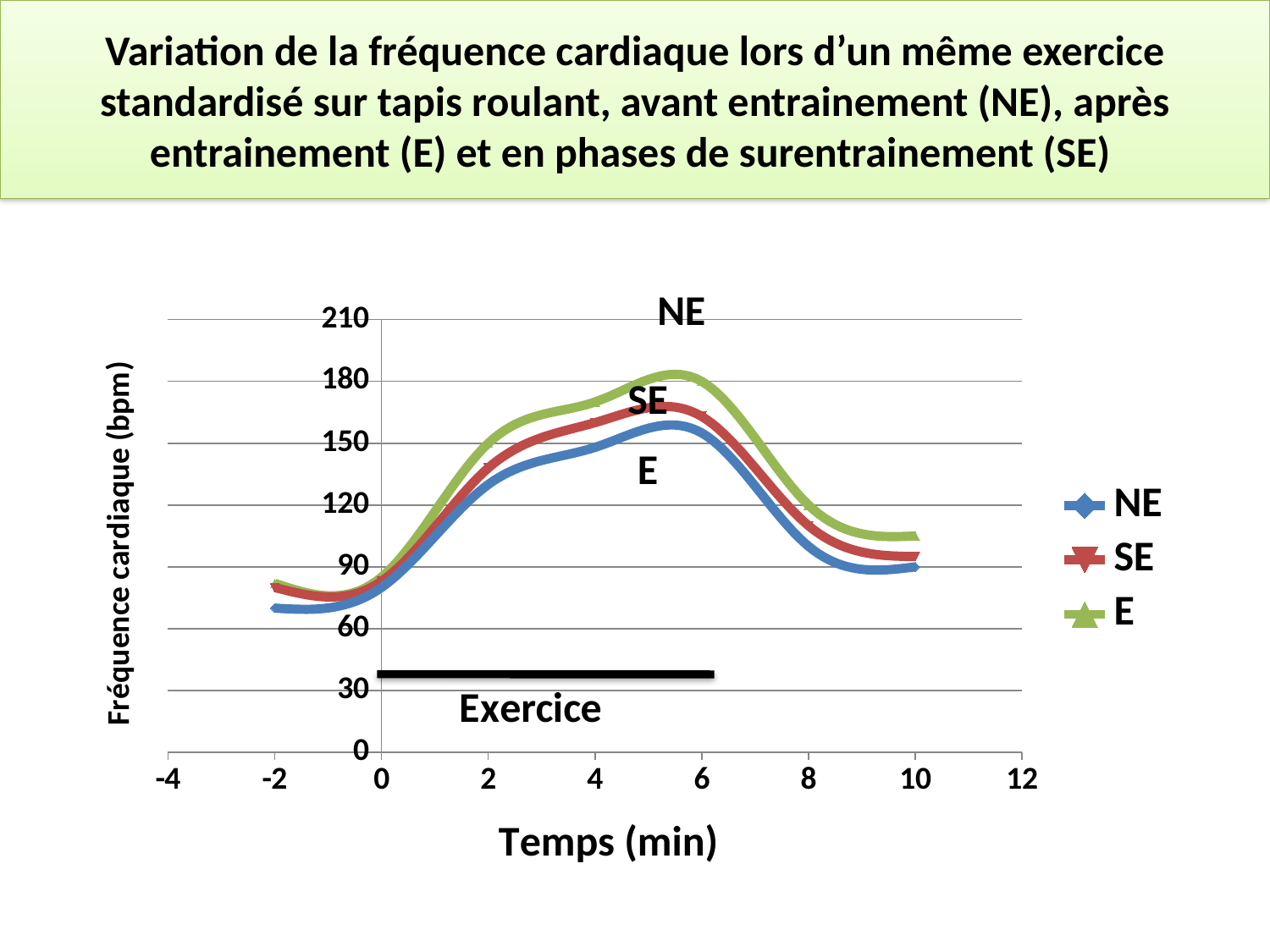
Is the value of the red line at -2 min greater or less than 120? less Is the peak value of the green line greater or less than 150? greater What kind of chart is shown on the slide? line chart Is the value of the green line at 4 min greater or less than 150? greater How many series does the legend list? 3 At 10 min, which line is higher, the green line or the blue line? green line What is the title of the y axis? Fréquence cardiaque (bpm) Between 6 and 9 min, do the heart rate values rise or fall? fall Which coloured line reaches the highest peak value? green line Between 0 and 5 min, do the heart rate values rise or fall? rise What are the series names listed in the legend? NE, SE, E